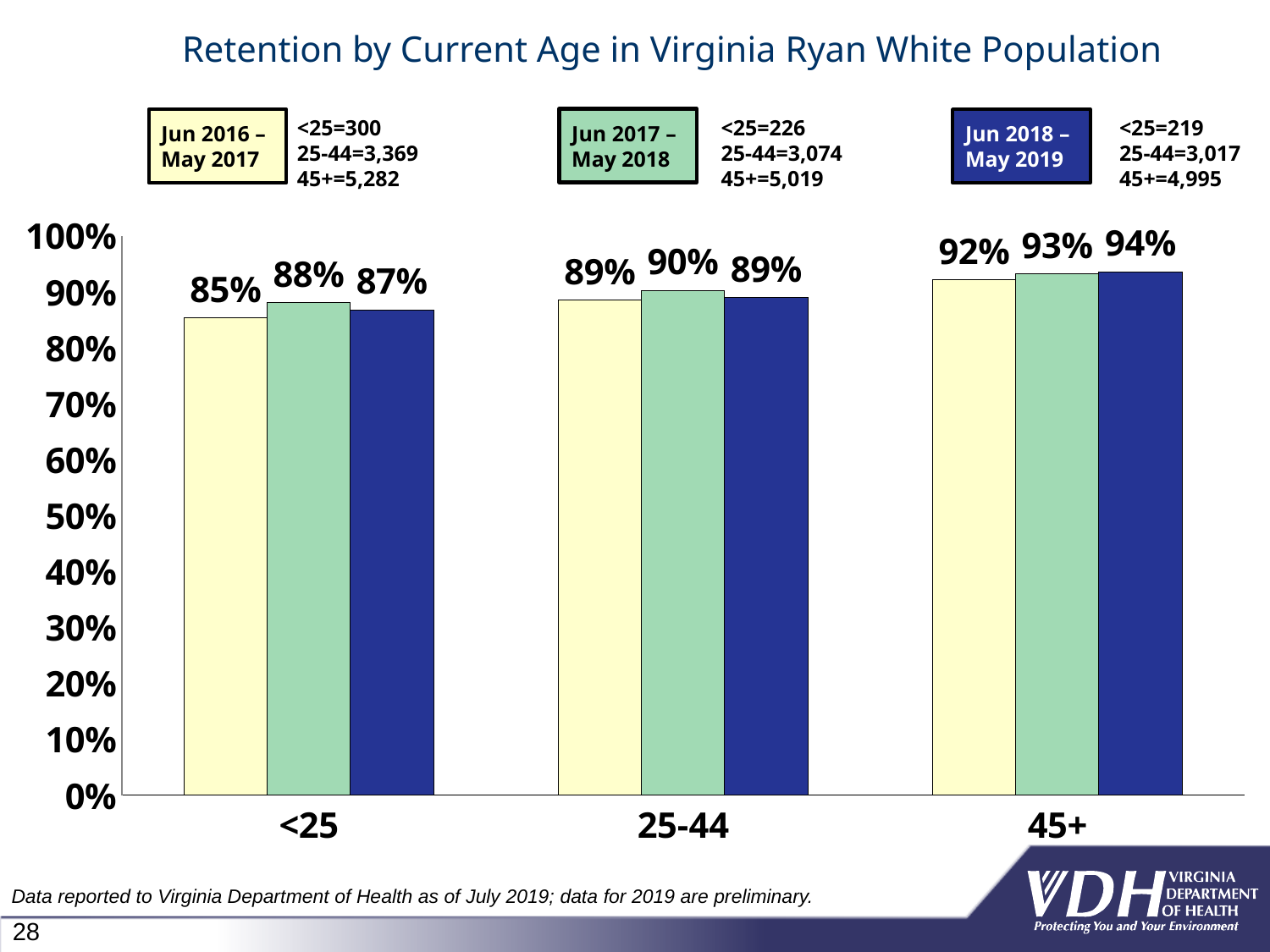
What is the retention value for the <25 age group in Jun 2016 – May 2017? 85% What kind of chart is shown on the slide? Bar chart What is the difference between the 45+ and <25 retention values in Jun 2016 – May 2017? 7% Which age group has the lowest retention in Jun 2016 – May 2017? <25 What is the retention value for the 25-44 age group in Jun 2017 – May 2018? 90% Which age group has the highest retention in Jun 2018 – May 2019? 45+ What is the title of the chart? Retention by Current Age in Virginia Ryan White Population Which is larger for the <25 age group: the Jun 2017 – May 2018 value or the Jun 2018 – May 2019 value? Jun 2017 – May 2018 How many age groups are shown on the x axis? 3 What is the retention value for the 45+ age group in Jun 2018 – May 2019? 94% How many series (time periods) does the legend list? 3 Do the Jun 2018 – May 2019 retention values rise or fall from the <25 group to the 45+ group? Rise